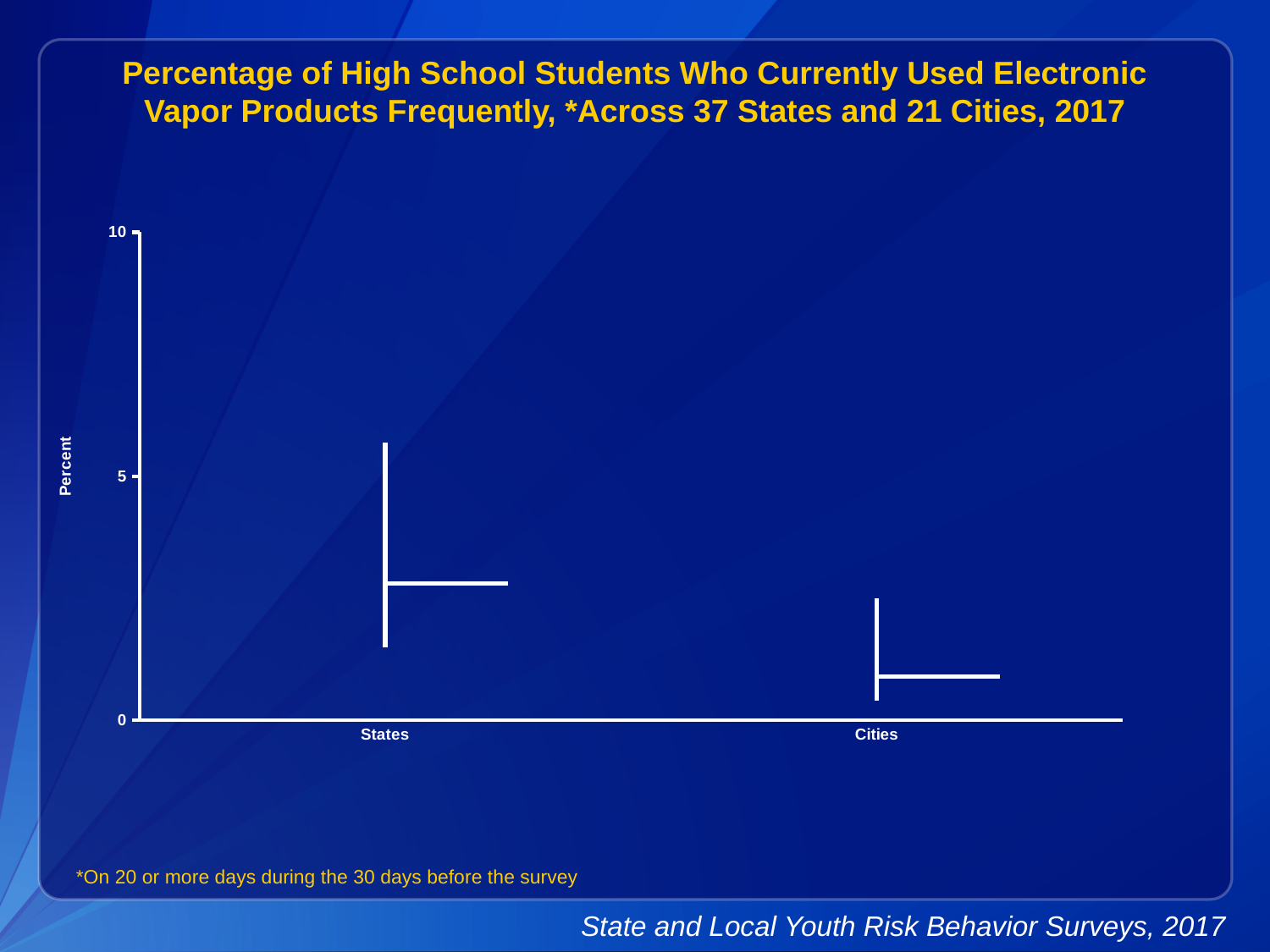
Is the upper end of the range for Cities greater or less than 5? less Is the value for Cities greater or less than 5? less Which category has the lowest value? Cities What is the maximum value shown on the y axis? 10 What is the label on the y axis of the chart? Percent Is the upper end of the range for States greater or less than 5? greater Which category has the highest value? States Which category has the higher value, States or Cities? States How many categories are shown on the x axis of the chart? 2